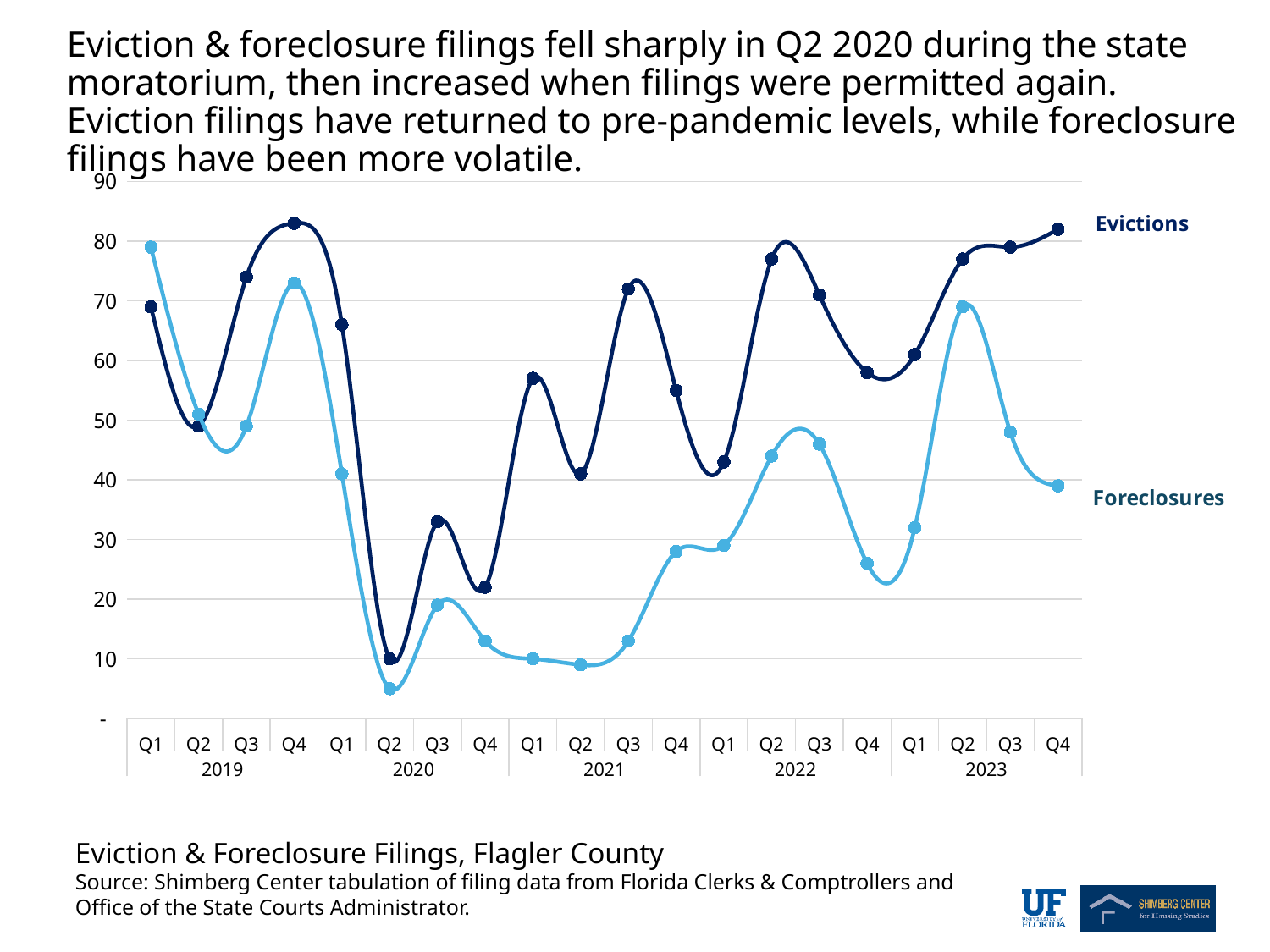
Do eviction filings rise or fall from Q4 2022 to Q4 2023? rise Is the value for foreclosures in Q1 2019 greater or less than 70? greater What kind of chart is shown on the slide? line chart Is the value for evictions in Q3 2021 greater or less than 60? greater How many quarterly data points does each line have? 20 Is the value for evictions in Q2 2020 greater or less than 20? less In which quarter do eviction filings reach their lowest point? Q2 2020 In Q4 2023, which series has the higher value, Evictions or Foreclosures? Evictions In which quarter do foreclosure filings reach their highest point? Q1 2019 How many series does the chart show? 2 What is the title of the chart given at the bottom of the slide? Eviction & Foreclosure Filings, Flagler County In which quarter do foreclosure filings reach their lowest point? Q2 2020